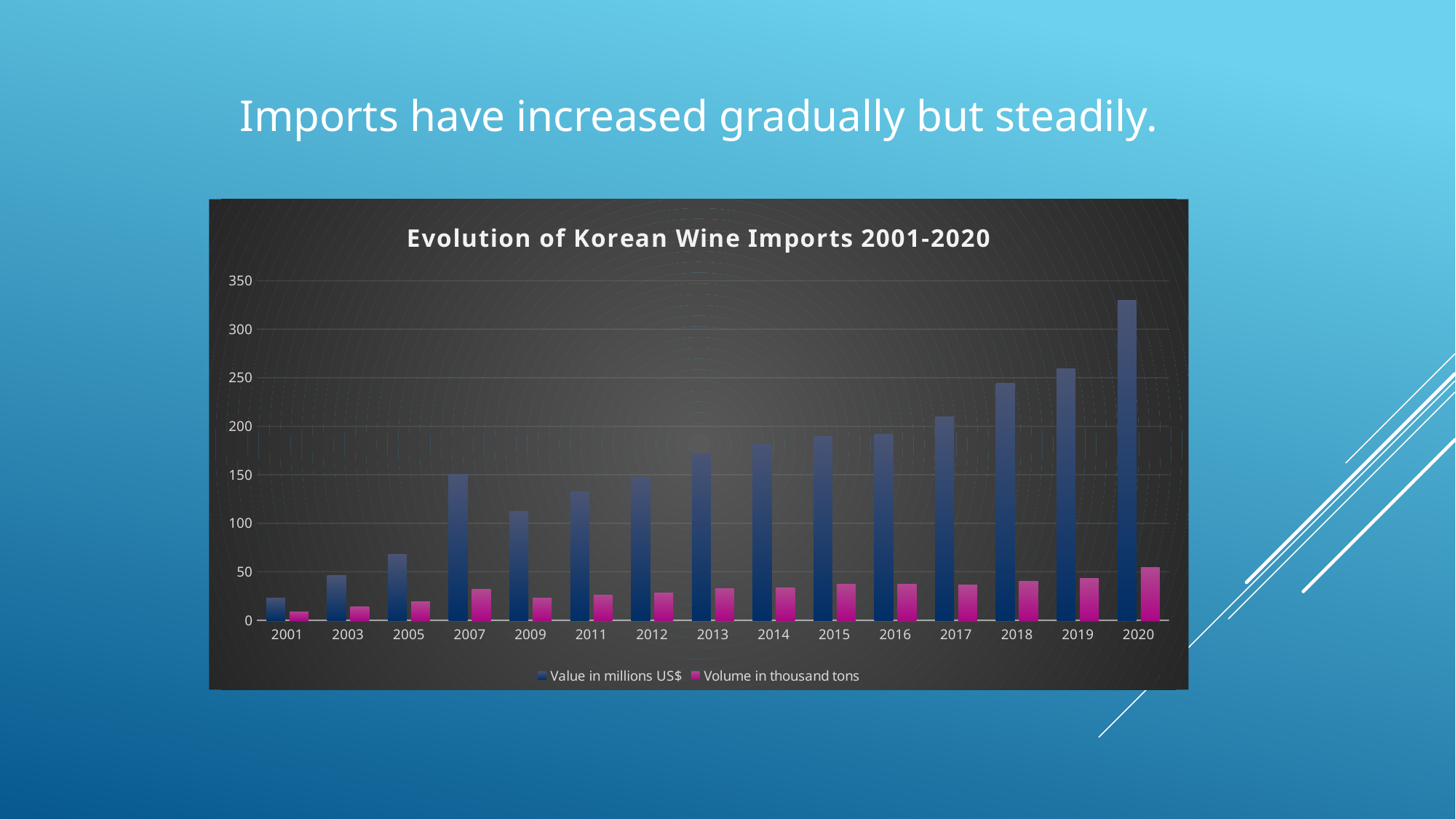
What kind of chart is shown on the slide? bar chart What is the title of the chart? Evolution of Korean Wine Imports 2001-2020 How many years are shown on the x axis? 15 Which year has the highest value in millions US$? 2020 Is the value in millions US$ for 2017 greater or less than 200? greater Is the value in millions US$ for 2001 greater or less than 50? less Is the value in millions US$ for 2020 greater or less than 300? greater Do the values in millions US$ generally rise or fall from 2001 to 2020? rise Which year has the lowest volume in thousand tons? 2001 Which year has the larger value in millions US$, 2007 or 2009? 2007 How many series does the legend list? 2